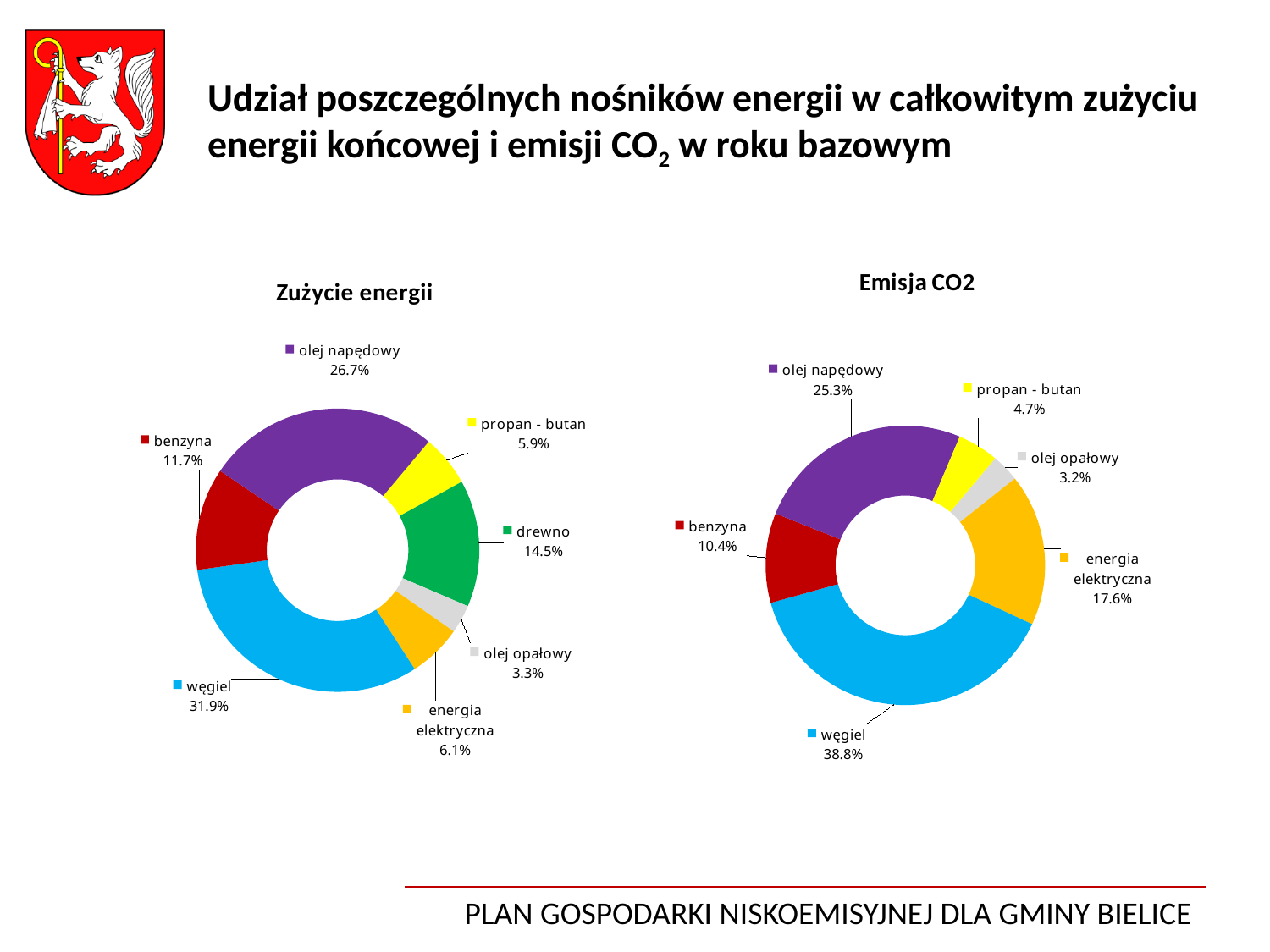
In the 'Zużycie energii' chart, which category has the smallest share? olej opałowy In the 'Emisja CO2' chart, what is the difference between the shares of węgiel and olej napędowy? 13.5% In the 'Emisja CO2' chart, what is the share for olej napędowy? 25.3% What type of chart is the 'Zużycie energii' chart? Doughnut (pie) chart In the 'Emisja CO2' chart, which category has the smallest share? olej opałowy In the 'Emisja CO2' chart, what is the share for energia elektryczna? 17.6% How many categories are shown in the 'Zużycie energii' chart? 7 In the 'Zużycie energii' chart, which is larger: the share of benzyna or the share of energia elektryczna? benzyna How many categories are shown in the 'Emisja CO2' chart? 6 In the 'Zużycie energii' chart, what is the share for drewno? 14.5% In the 'Zużycie energii' chart, which category has the largest share? węgiel In the 'Zużycie energii' chart, what is the share for węgiel? 31.9%